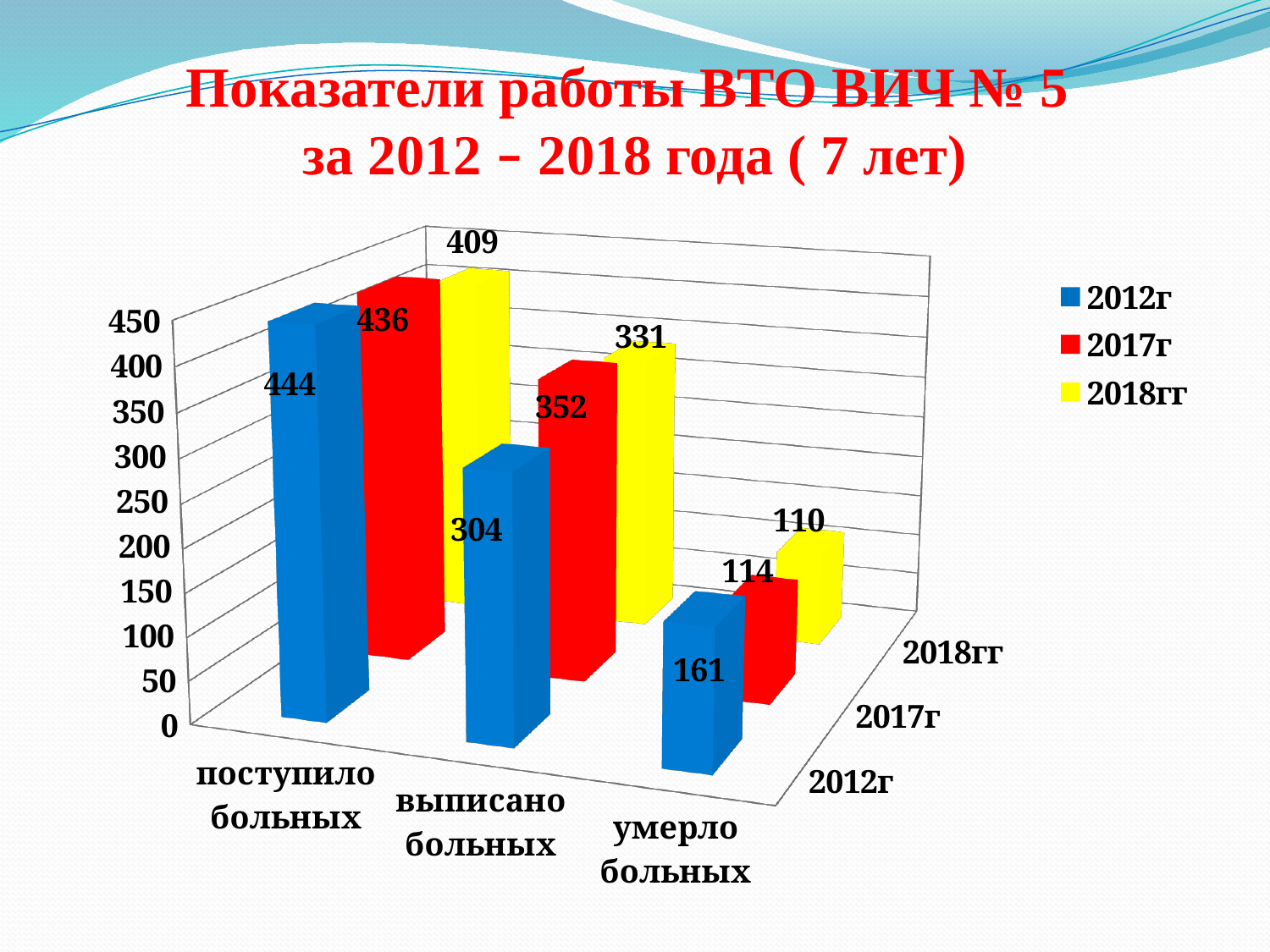
What is the value for "поступило больных" in the 2018гг series? 409 What is the value for "поступило больных" in the 2012г series? 444 What is the value for "выписано больных" in the 2017г series? 352 What is the value for "умерло больных" in the 2018гг series? 110 What kind of chart is shown on the slide? bar chart Which is larger: the 2017г value for "умерло больных" or the 2018гг value for "умерло больных"? 2017г How many series does the legend list? 3 How many categories are shown on the x axis? 3 Which series has the highest value for "выписано больных"? 2017г What colour represents the 2018гг series? yellow Which category has the lowest value in the 2012г series? умерло больных What is the difference between the 2012г and 2018гг values for "поступило больных"? 35